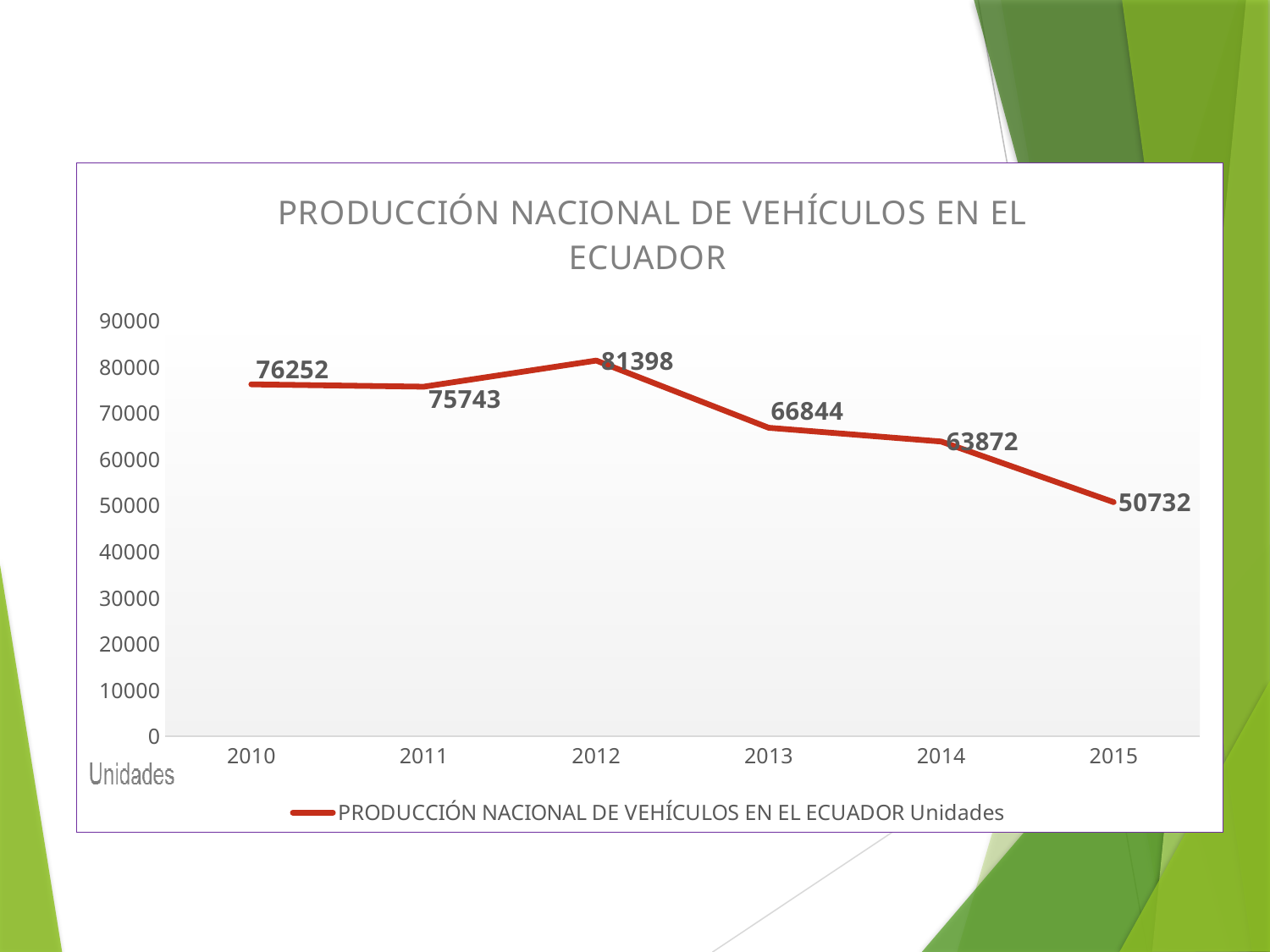
What kind of chart is shown on the slide? Line chart What is the difference between the 2013 and 2014 values? 2972 What is the difference between the 2012 and 2015 values? 30666 Which year had the highest vehicle production? 2012 Which year had the lowest vehicle production? 2015 What value is shown for 2012? 81398 What was the production in 2015? 50732 What was the national vehicle production in Ecuador in 2010? 76252 Do the values rise or fall from 2012 to 2015? Fall What value is shown for 2013? 66844 How many years are plotted on the chart? 6 Which year had higher production, 2011 or 2014? 2011